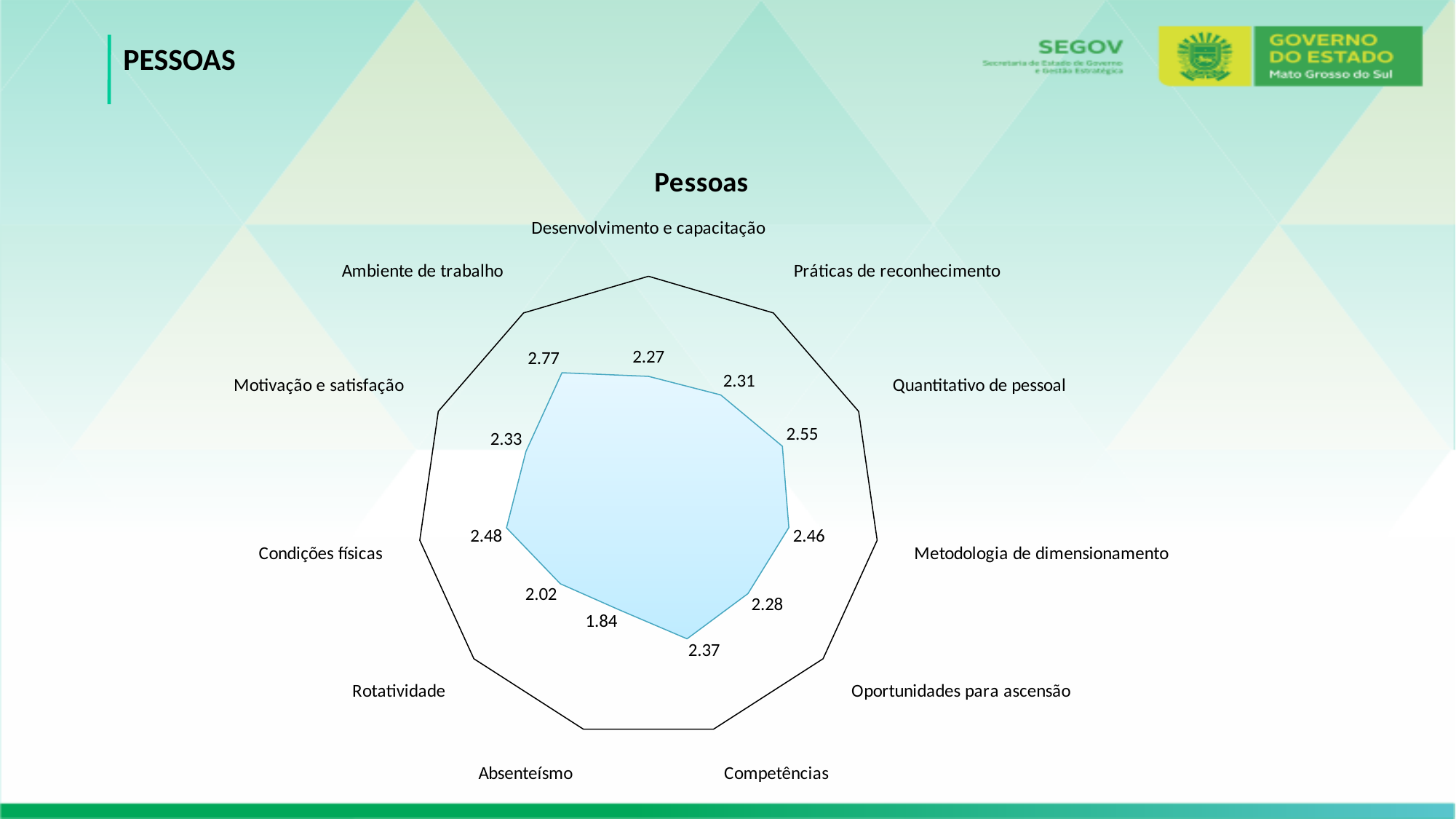
What is the value for Rotatividade? 2.02 What is the value for Quantitativo de pessoal? 2.55 What is the value for Absenteísmo? 1.84 Which category has the lowest value? Absenteísmo What is the title of the chart? Pessoas Which is larger, the value for Condições físicas or the value for Oportunidades para ascensão? Condições físicas Which category has the highest value? Ambiente de trabalho What is the difference between the values for Quantitativo de pessoal and Metodologia de dimensionamento? 0.09 What type of chart is shown on the slide? Radar chart What is the value for Ambiente de trabalho? 2.77 What is the difference between the values for Ambiente de trabalho and Absenteísmo? 0.93 How many categories does the radar chart have? 11